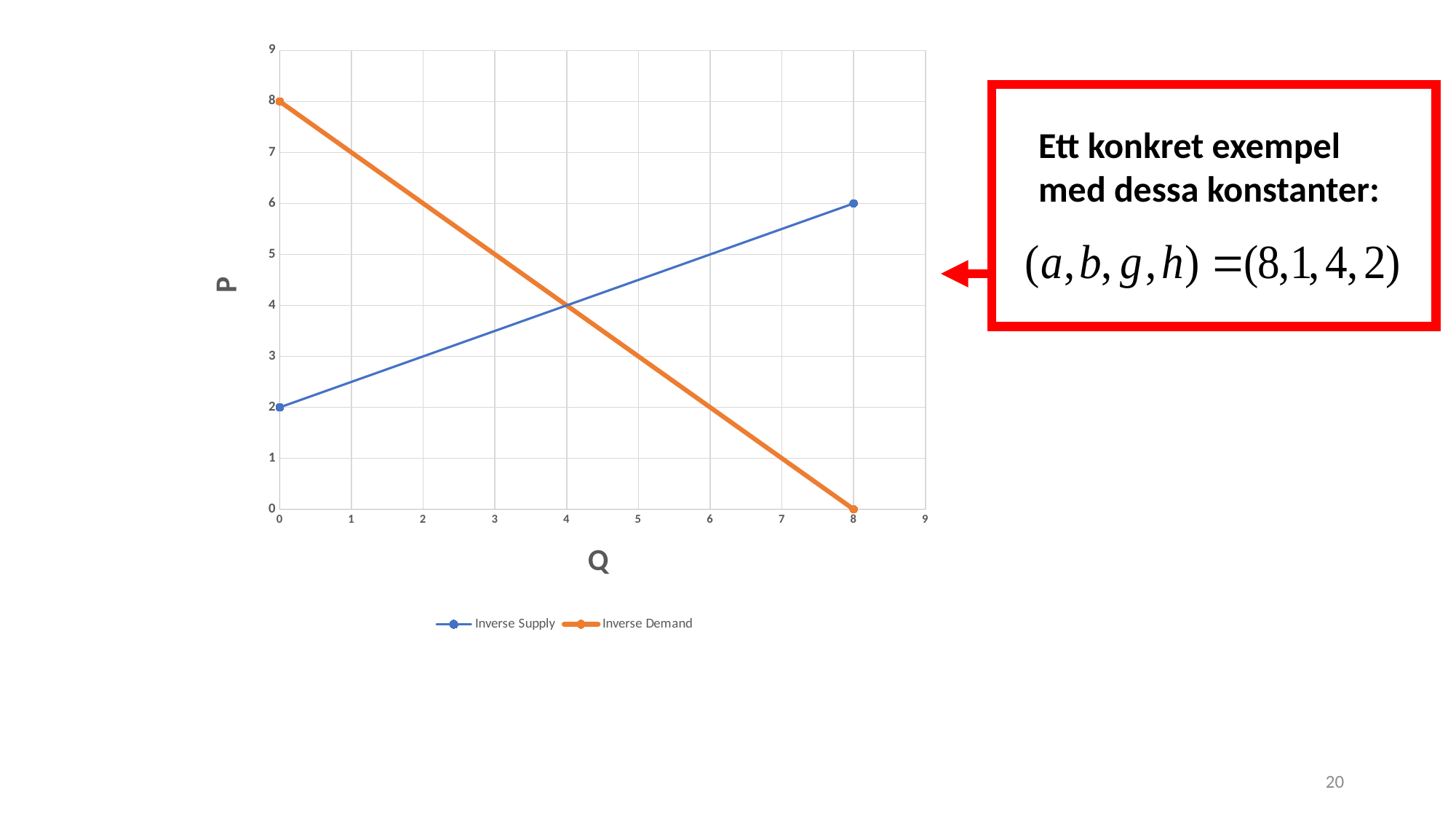
What is the value of P for Inverse Supply at Q = 0? 2 What are the names of the two series in the legend? Inverse Supply and Inverse Demand Does the Inverse Demand line rise or fall as Q increases? fall What kind of chart is shown on the slide? line chart At Q = 0, which series has the higher value of P, Inverse Supply or Inverse Demand? Inverse Demand Does the Inverse Supply line rise or fall as Q increases? rise How many series does the legend list? 2 What is the label of the horizontal axis? Q What is the value of P for Inverse Demand at Q = 8? 0 What is the value of P for Inverse Demand at Q = 0? 8 What is the value of P for Inverse Supply at Q = 8? 6 What is the difference between the Inverse Demand value and the Inverse Supply value at Q = 0? 6